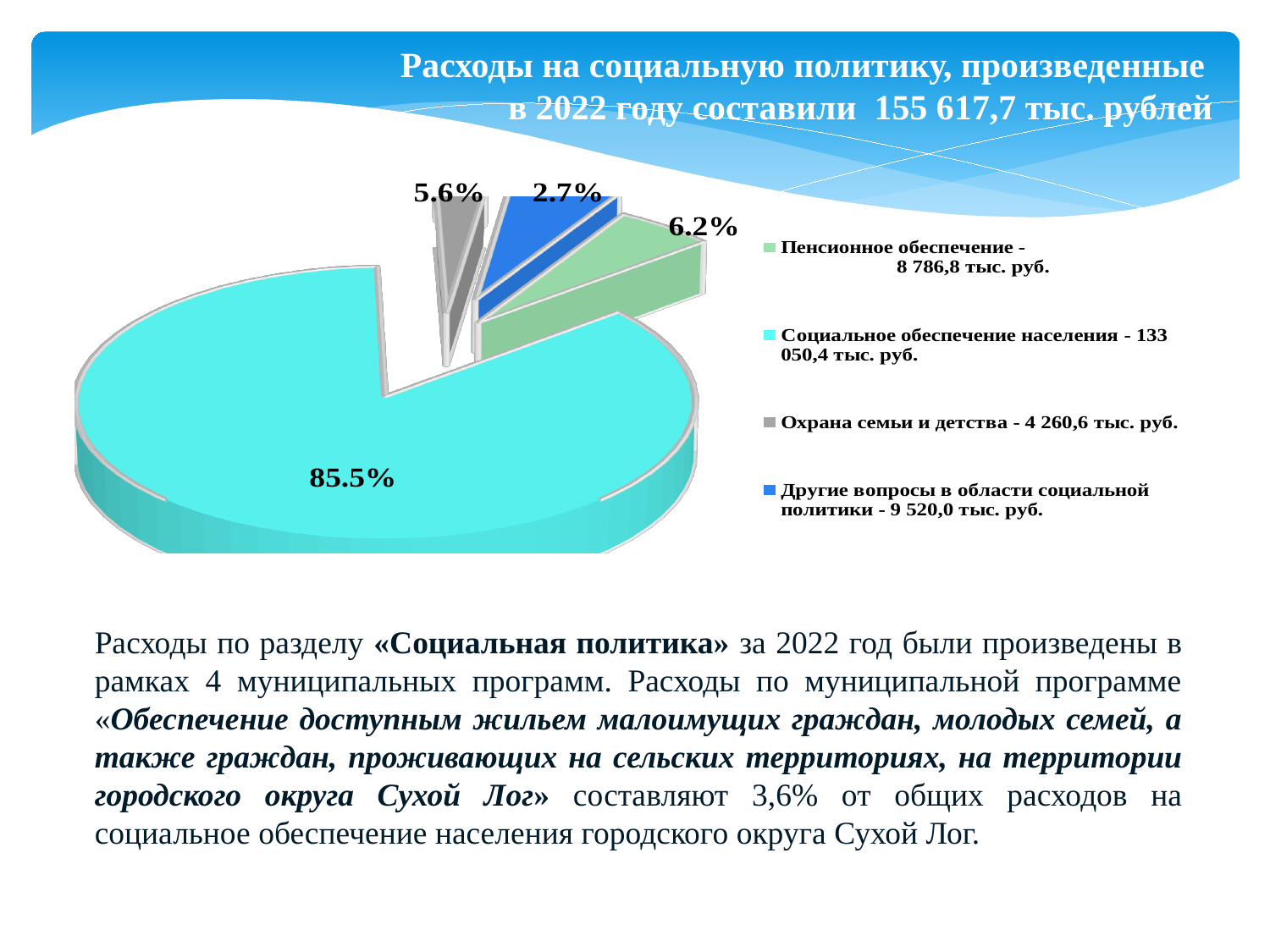
What total amount of social policy expenditure for 2022 is stated in the slide title? 155 617,7 тыс. рублей According to the legend, what is the amount for Охрана семьи и детства? 4 260,6 тыс. руб. Which is larger according to the legend: Пенсионное обеспечение or Другие вопросы в области социальной политики? Другие вопросы в области социальной политики According to the legend, what is the amount for Пенсионное обеспечение? 8 786,8 тыс. руб. What share of the pie does the largest slice (Социальное обеспечение населения) take? 85.5% What is the difference between the legend amounts for Социальное обеспечение населения and Пенсионное обеспечение? 124 263,6 тыс. руб. Which category has the largest slice of the pie? Социальное обеспечение населения According to the legend, what is the amount for Другие вопросы в области социальной политики? 9 520,0 тыс. руб. How many categories does the pie chart's legend list? 4 According to the legend, what is the amount for Социальное обеспечение населения? 133 050,4 тыс. руб. What kind of chart is shown on the slide? pie chart Which category has the smallest amount according to the legend? Охрана семьи и детства